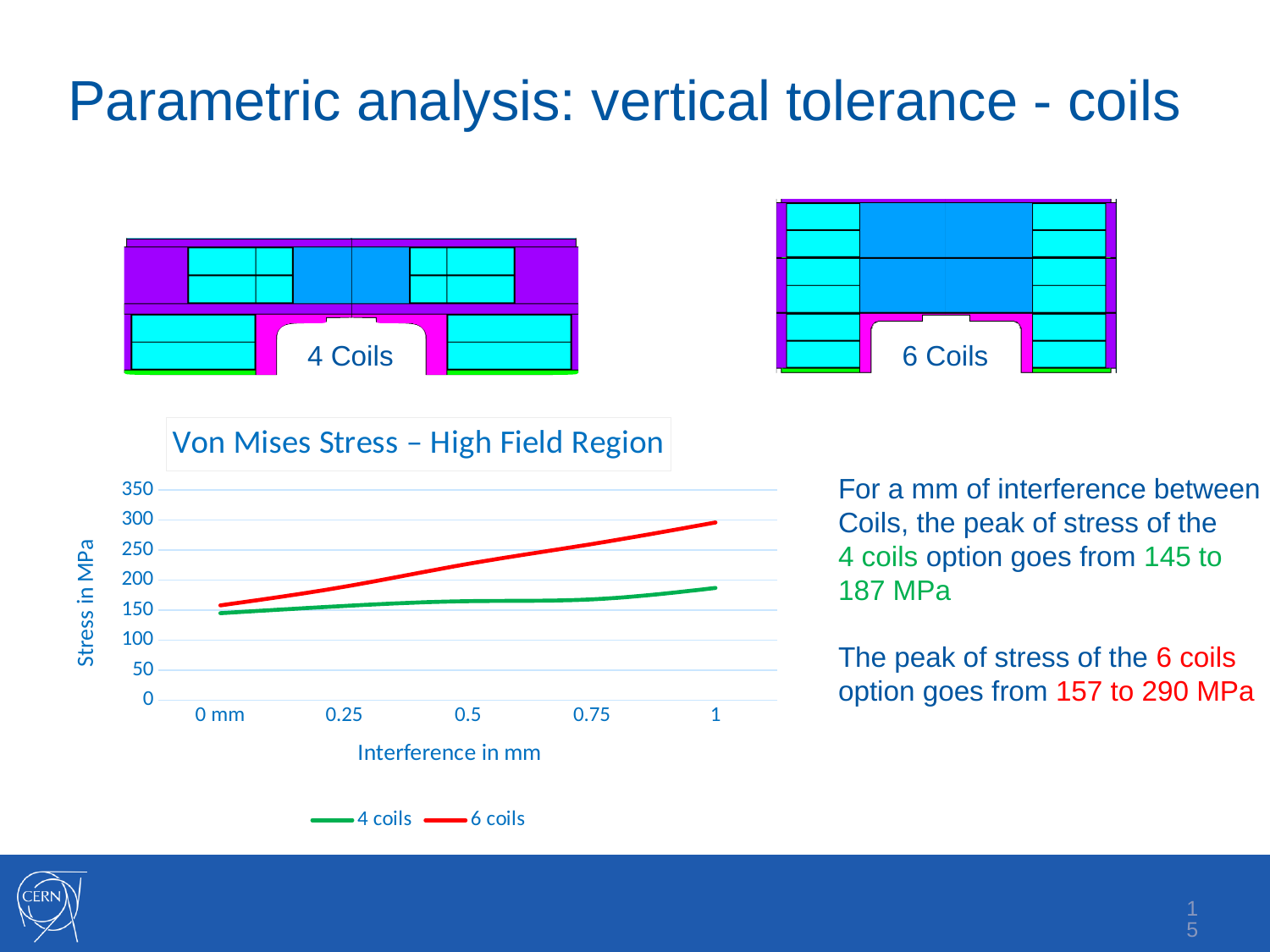
Does the stress for the 6 coils series rise or fall as interference increases from 0 mm to 1 mm? rise Is the stress for the 6 coils series at 1 mm of interference greater or less than 250? greater Is the stress for the 6 coils series at 0.5 mm of interference greater or less than 200? greater How many series does the chart legend list? 2 What is the title of the chart? Von Mises Stress – High Field Region What kind of chart is shown on the slide? line chart According to the slide, what is the peak stress of the 6 coils option at 1 mm of interference? 290 MPa Which series has the higher stress at 1 mm of interference, 4 coils or 6 coils? 6 coils What is the label of the y axis of the chart? Stress in MPa According to the slide, what is the peak stress of the 4 coils option at 0 mm of interference? 145 MPa Is the stress for the 4 coils series at 1 mm of interference greater or less than 200? less How many interference values are marked along the x axis of the chart? 5